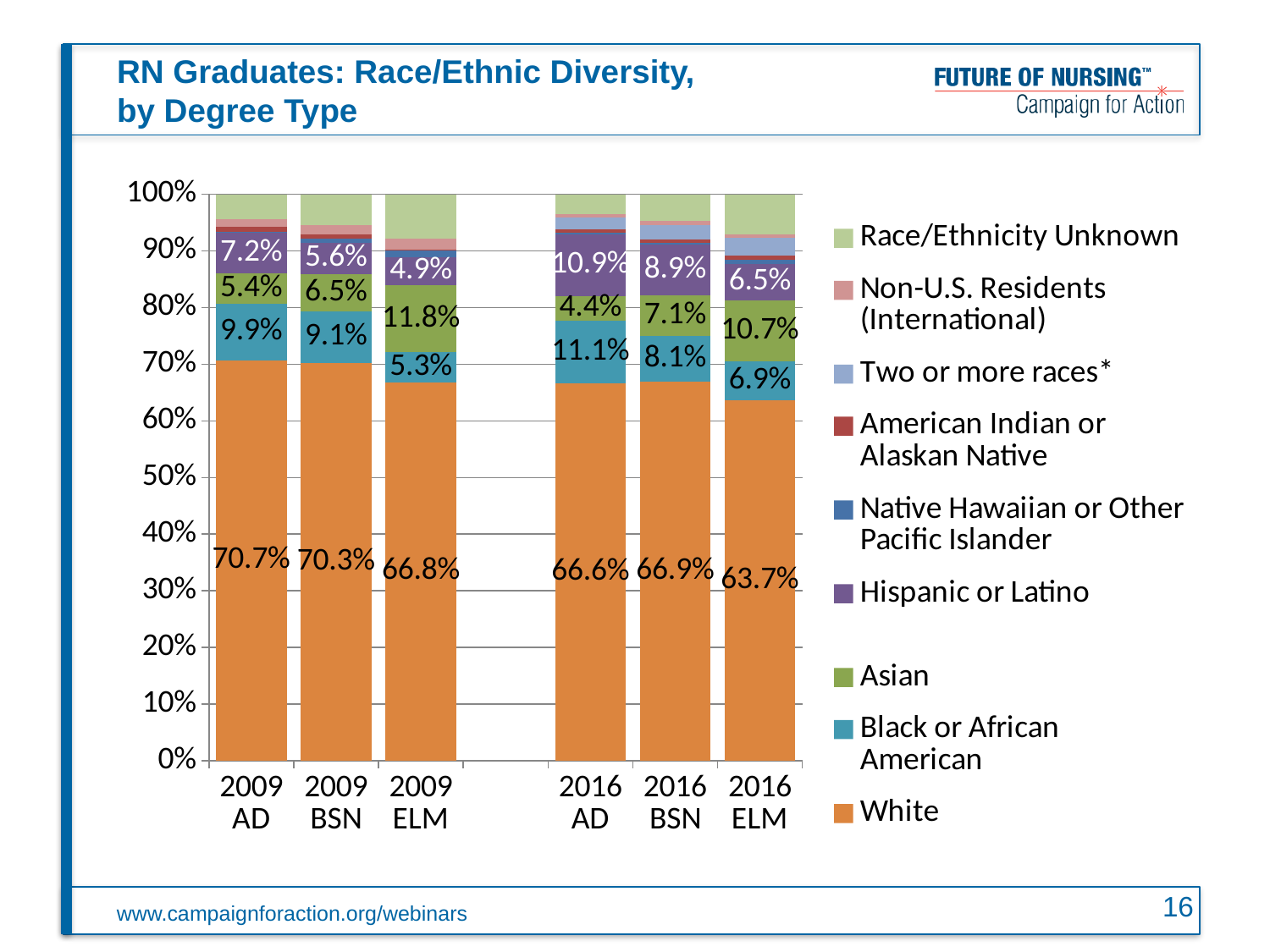
What is the difference in Asian share between 2009 ELM and 2009 AD? 6.4 percentage points Is the Black or African American share larger for 2016 AD or 2016 BSN? 2016 AD What is the Black or African American share for 2009 AD? 9.9% What is the Hispanic or Latino share for 2016 AD? 10.9% Which category has the highest Hispanic or Latino share? 2016 AD What is the White share for 2016 ELM? 63.7% Which category has the lowest White share? 2016 ELM What kind of chart is shown on the slide? Stacked bar chart What is the Asian share for 2009 ELM? 11.8% How many categories are shown on the x axis? 6 Which category has the highest White share? 2009 AD How many series does the legend list? 9